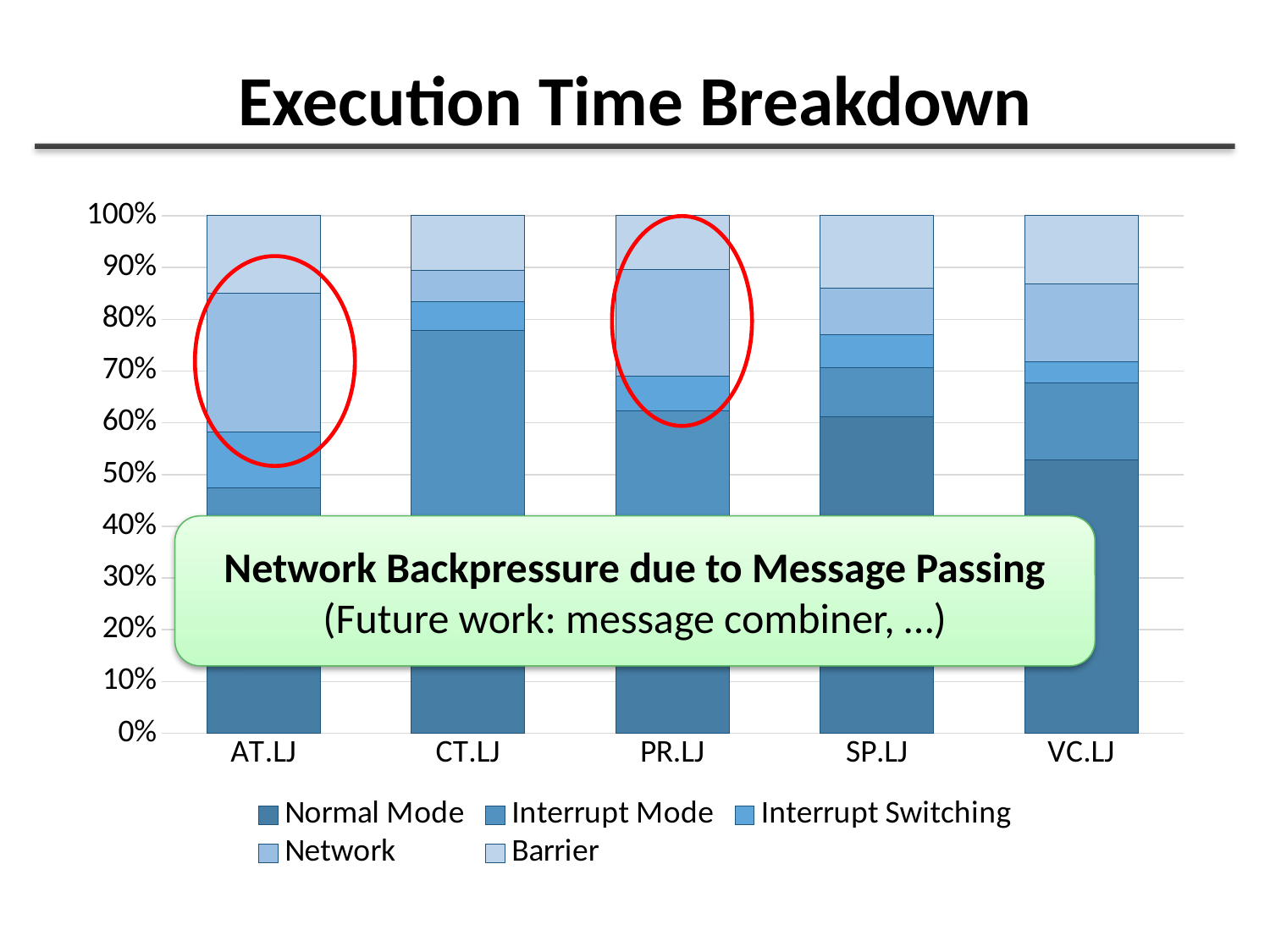
Is the Normal Mode share for SP.LJ greater or less than 50%? greater What kind of chart is shown on the slide? Stacked bar chart Which category has the smallest Network share? CT.LJ Is the Network share for AT.LJ greater or less than 20%? greater How many series does the legend list? 5 Which series is plotted at the top of each stacked bar? Barrier Which category has the largest Normal Mode share? SP.LJ What is the title of the chart? Execution Time Breakdown How many categories are shown on the x axis? 5 Is the Normal Mode share for VC.LJ greater or less than 60%? less Which category has the larger Network share, AT.LJ or CT.LJ? AT.LJ What is the total of each stacked bar? 100%